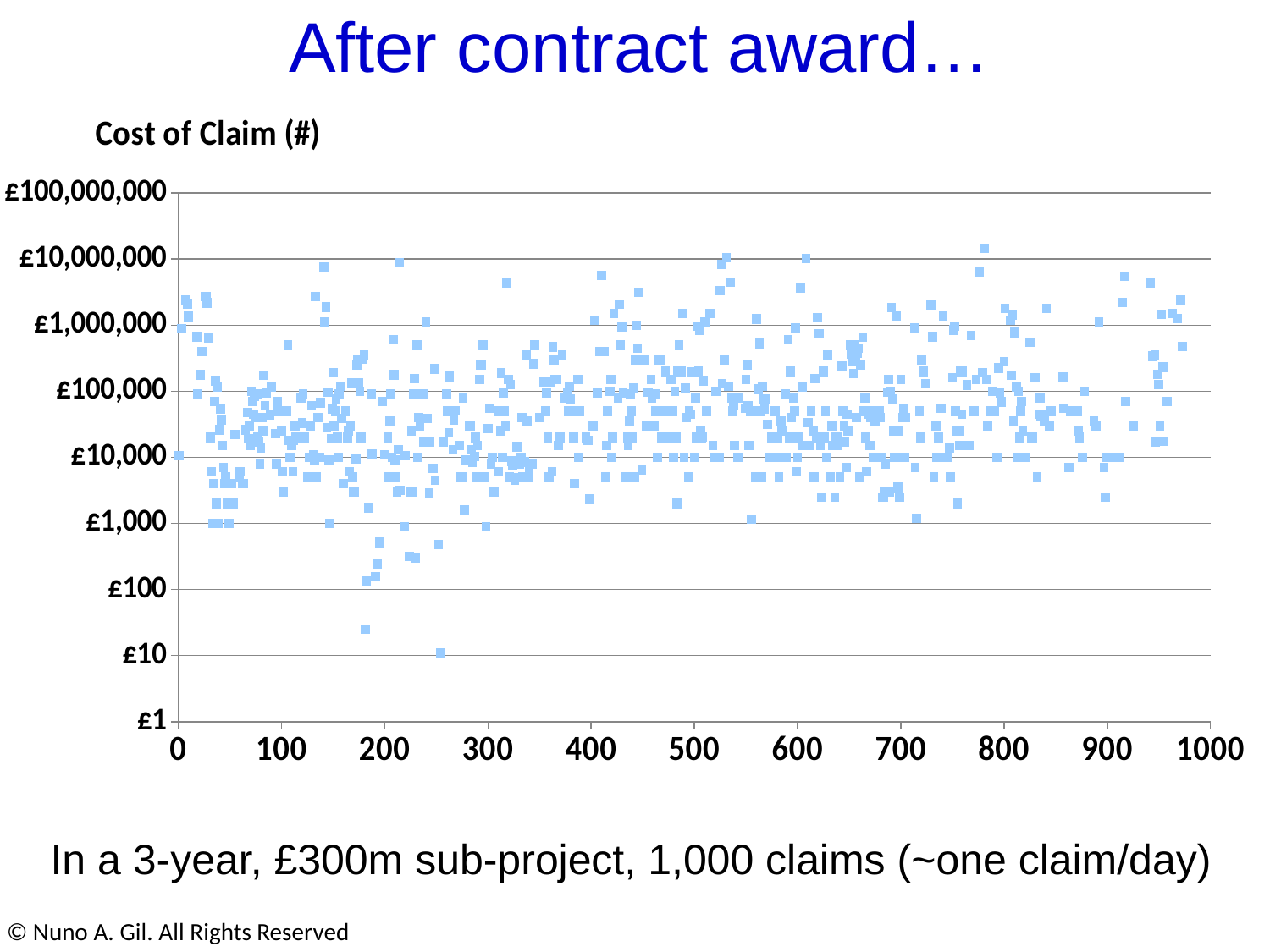
Is the lowest plotted point (near x = 250) greater or less than £100? less How many labelled tick marks are there on the x axis? 11 How many labelled tick marks are there on the y axis? 9 What is the highest value labelled on the y axis? £100,000,000 What colour are the plotted markers? Light blue What kind of chart is shown on the slide? Scatter chart What is the largest value labelled on the x axis? 1000 What is the title of the chart? Cost of Claim (#) What is the lowest value labelled on the y axis? £1 Do the plotted values show a clear rising or falling trend along the x axis? No clear trend Is the highest plotted point (near x = 780) greater or less than £1,000,000? greater